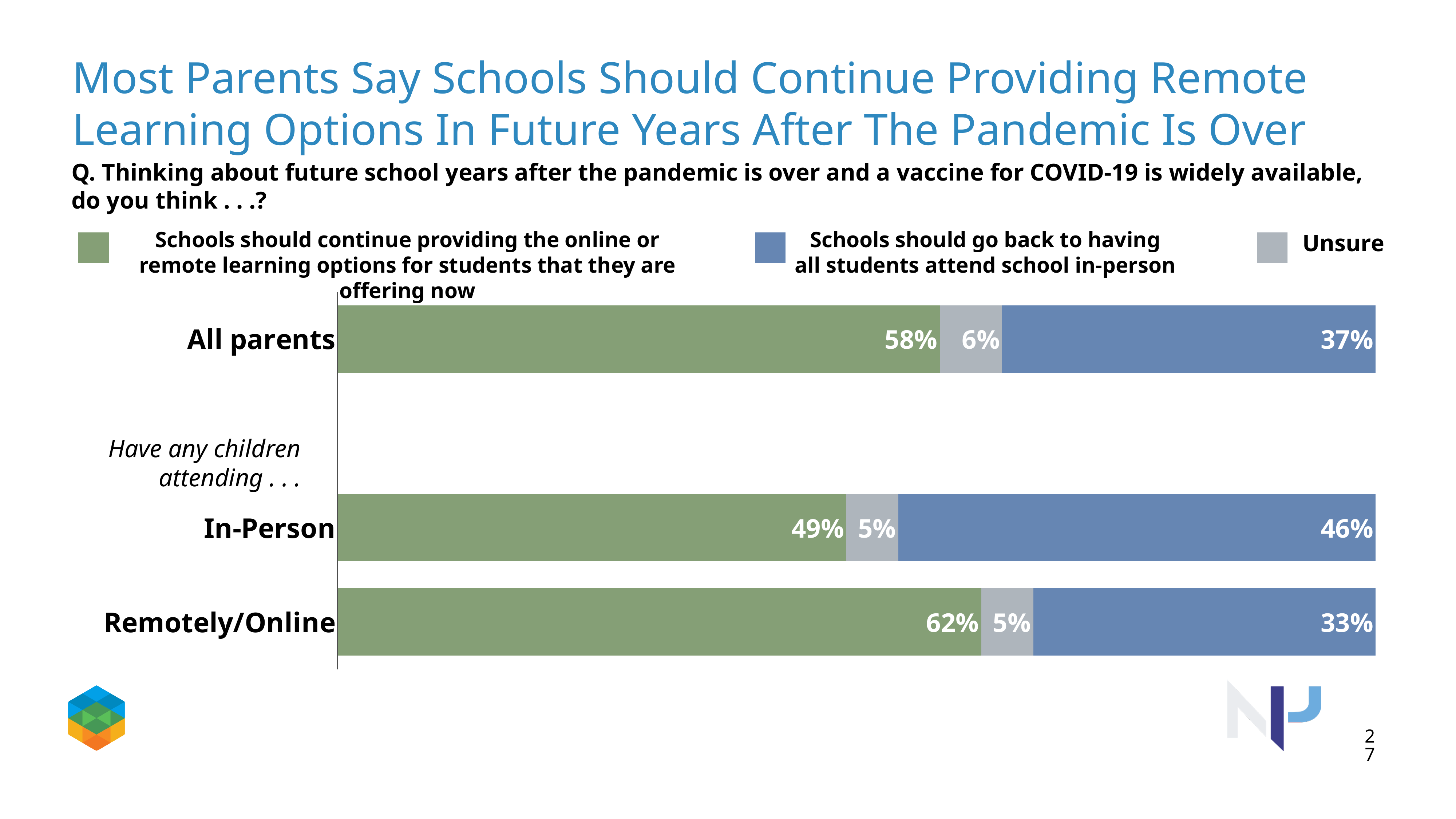
Which group has the highest share saying schools should continue providing online or remote learning options? Remotely/Online What percentage of all parents say schools should go back to having all students attend school in-person? 37% Which is larger: the share of In-Person parents who say schools should continue remote options, or the share who say schools should go back to in-person? Schools should continue providing the online or remote learning options (49%) What percentage of all parents say schools should continue providing the online or remote learning options? 58% What percentage of parents with children attending remotely/online are unsure? 5% Which group has the lowest share saying schools should go back to having all students attend school in-person? Remotely/Online How many series does the legend list? 3 What percentage of parents with children attending in-person say schools should go back to having all students attend school in-person? 46% What colour represents the 'Unsure' response in the chart? Gray What is the difference between the share of Remotely/Online parents and In-Person parents who say schools should continue providing online or remote learning options? 13 percentage points How many groups (bars) are shown in the chart? 3 What kind of chart is shown on the slide? Stacked horizontal bar chart